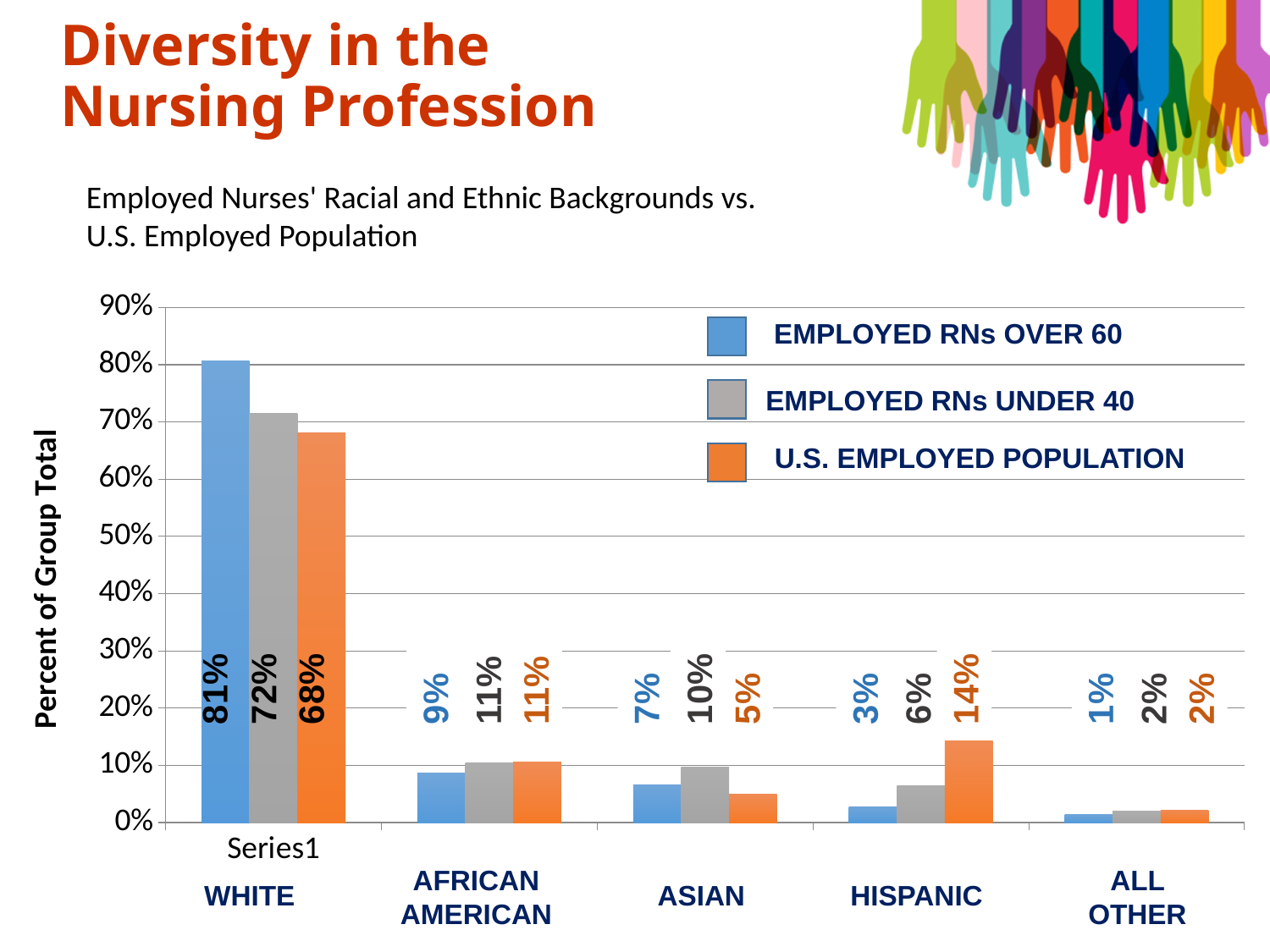
What percentage of employed RNs over 60 are White? 81% What percentage of employed RNs under 40 are Asian? 10% What is the label of the y axis? Percent of Group Total What is the value for the U.S. Employed Population in the Hispanic category? 14% How many racial/ethnic categories are shown on the x axis? 5 Is the value for employed RNs under 40 in the White category greater or less than 60%? greater What is the difference between the White percentage for employed RNs over 60 and for the U.S. Employed Population? 13% How many series does the legend list? 3 In the Hispanic category, which is larger: employed RNs under 40 or the U.S. Employed Population? U.S. Employed Population What kind of chart is shown on the slide? Bar chart Which category has the highest value for employed RNs under 40? White Which category has the lowest value for employed RNs over 60? All Other